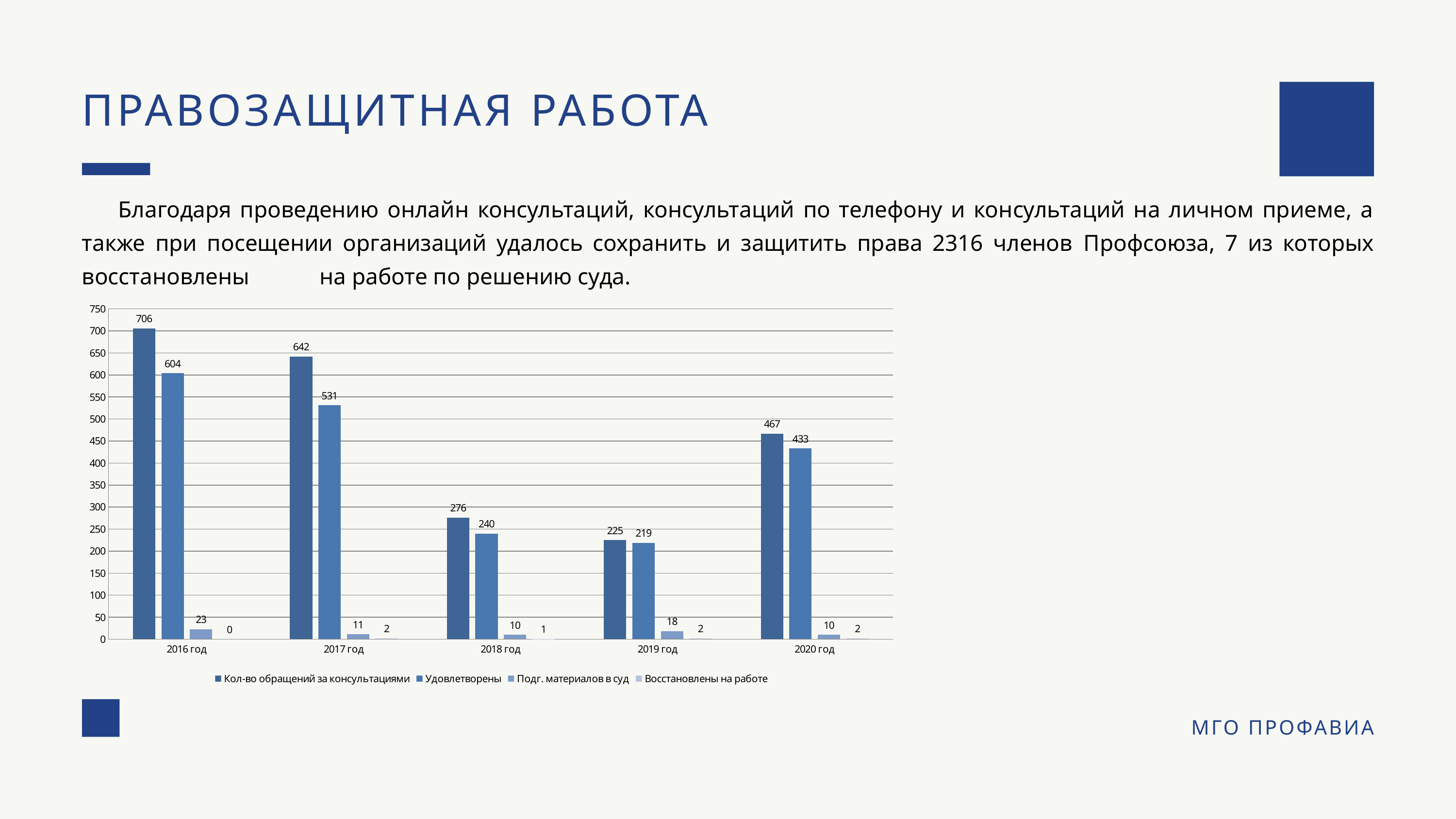
Which year has the highest value for "Кол-во обращений за консультациями"? 2016 год Which year has the lowest value for "Удовлетворены"? 2019 год Which is larger: "Подг. материалов в суд" in 2016 год or in 2017 год? 2016 год What is the value of "Удовлетворены" for 2020 год? 433 How many series does the legend list? 4 Does the value of "Кол-во обращений за консультациями" rise or fall from 2016 год to 2019 год? Fall What kind of chart is shown on the slide? Bar chart What is the difference between "Кол-во обращений за консультациями" and "Удовлетворены" in 2017 год? 111 What is the value of "Подг. материалов в суд" for 2019 год? 18 What is the value of "Восстановлены на работе" for 2018 год? 1 What is the value of "Кол-во обращений за консультациями" for 2016 год? 706 How many years are shown on the x axis? 5